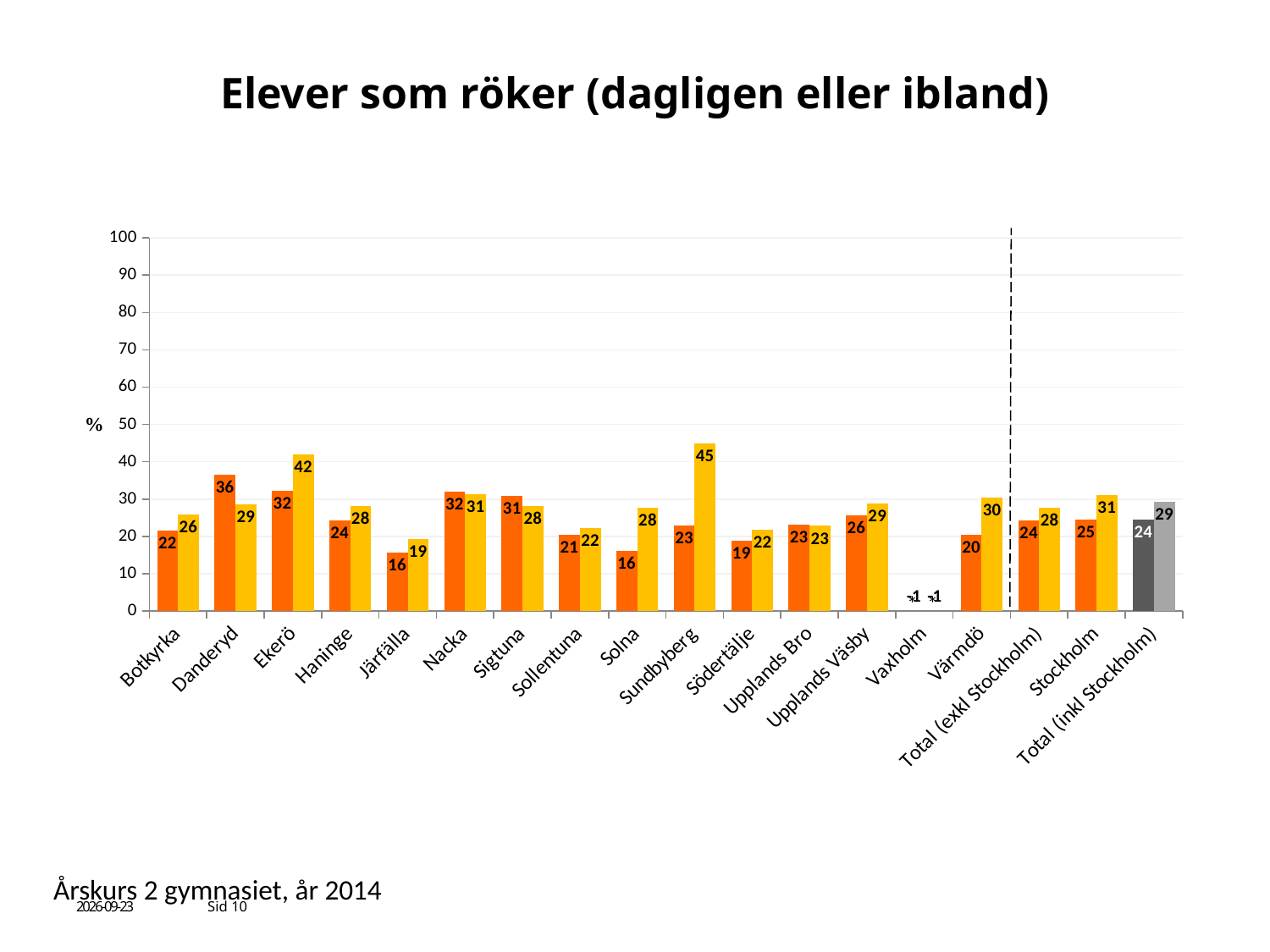
Is the value of the yellow bar for Ekerö greater or less than 40? greater What is the difference between the yellow and orange bars for Ekerö? 10 What is the title of the chart? Elever som röker (dagligen eller ibland) How many categories are shown along the x axis? 18 Which is larger for Nacka, the orange bar or the yellow bar? the orange bar What kind of chart is shown on the slide? bar chart What is the value of the orange bar for Danderyd? 36 Which category has the highest yellow bar? Sundbyberg What is the value of the yellow bar for Värmdö? 30 Which category has the highest orange bar? Danderyd What is the value of the yellow bar for Sundbyberg? 45 What is the difference between the yellow and orange bars for Solna? 12